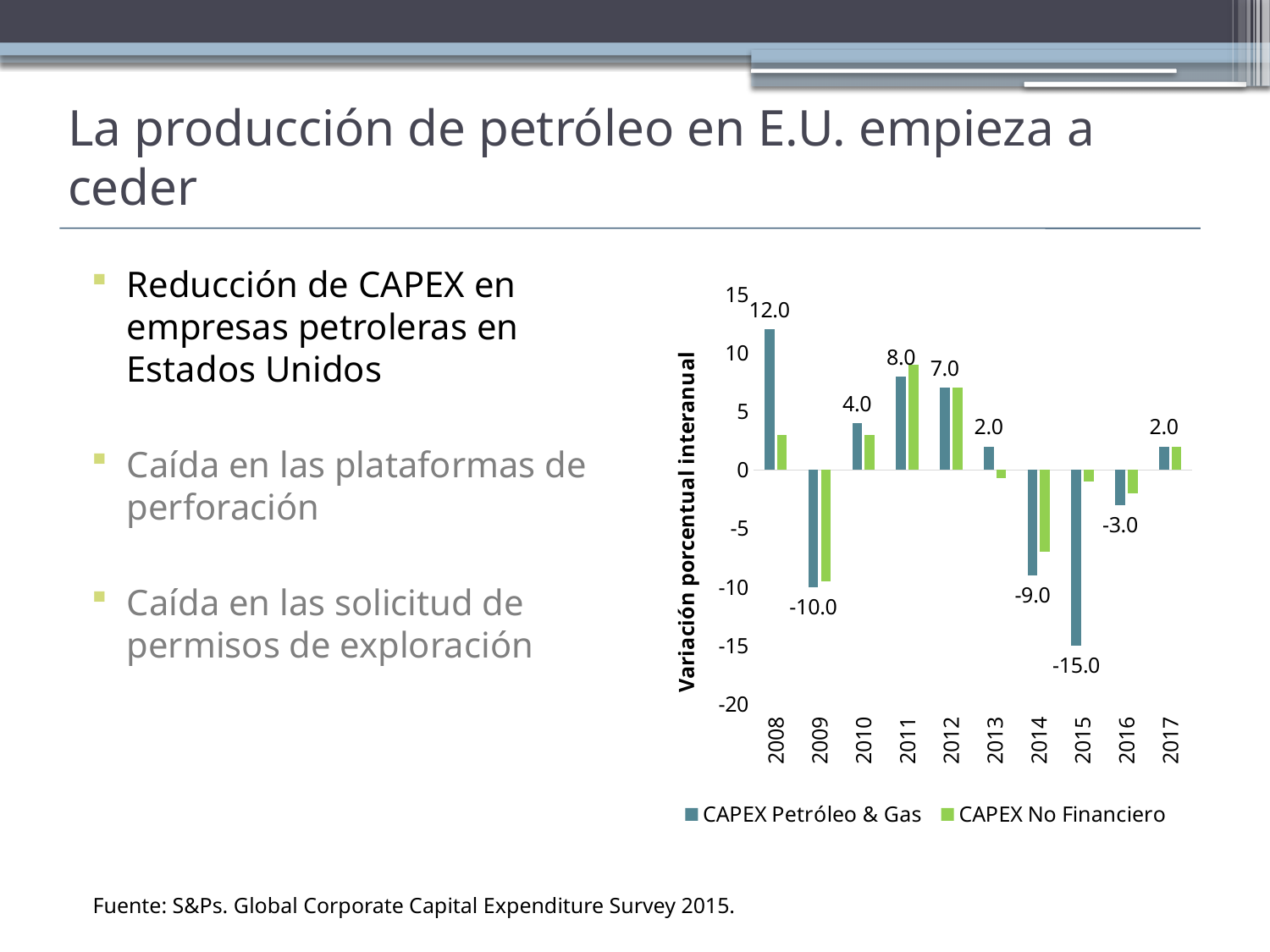
Is the value for CAPEX No Financiero in 2011 greater or less than 5? greater What is the value for CAPEX Petróleo & Gas in 2008? 12.0 What is the difference between the CAPEX Petróleo & Gas values for 2008 and 2015? 27.0 What is the value for CAPEX Petróleo & Gas in 2015? -15.0 What is the value for CAPEX Petróleo & Gas in 2011? 8.0 In which year is the CAPEX Petróleo & Gas value lowest? 2015 Which is larger for CAPEX Petróleo & Gas: the value for 2011 or the value for 2012? 2011 Is the value for CAPEX No Financiero in 2014 greater or less than -5? less What kind of chart is shown on the slide? Bar chart How many series does the legend list? 2 In which year is the CAPEX Petróleo & Gas value highest? 2008 How many years are shown on the x axis of the chart? 10